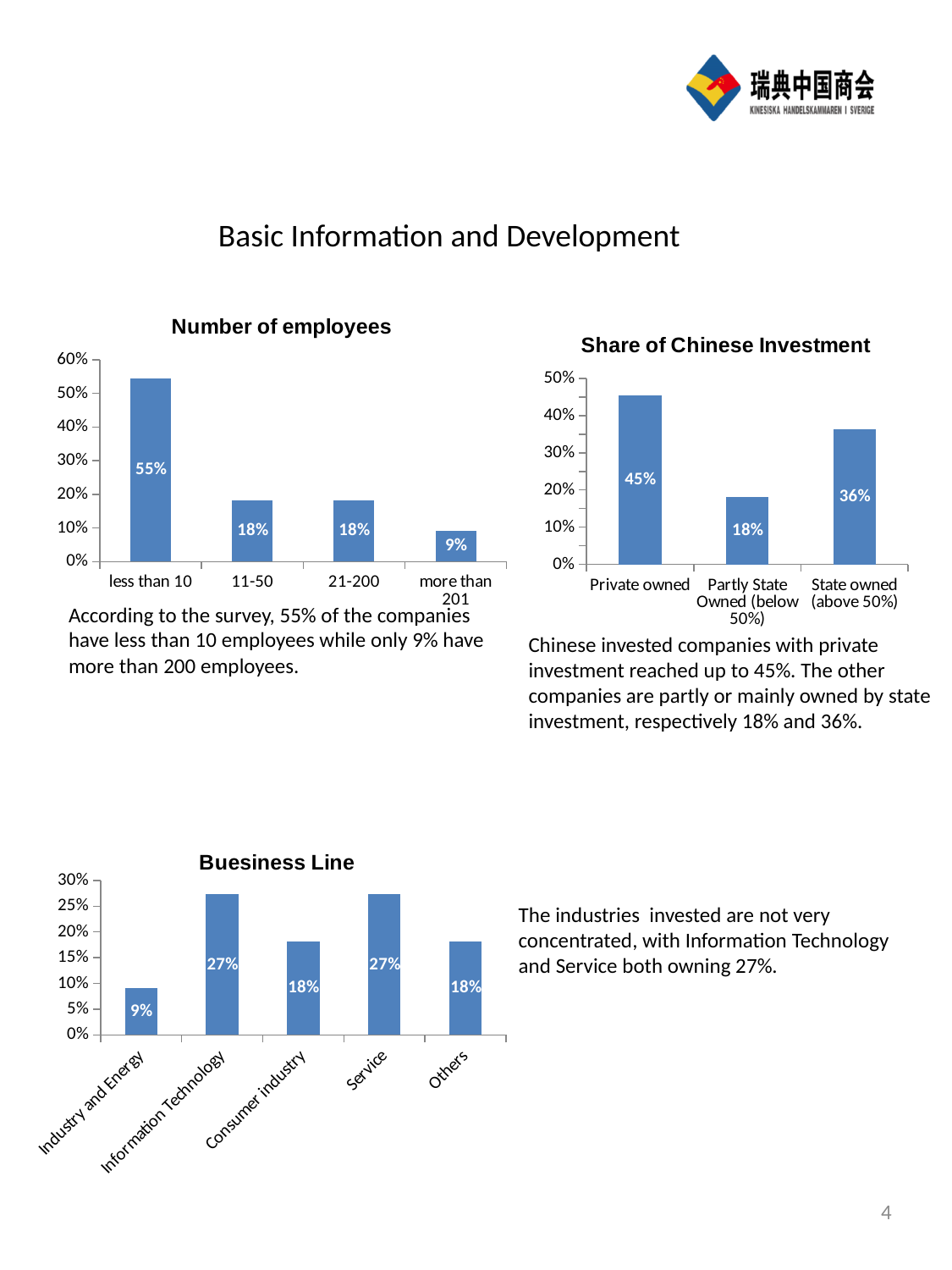
What type of chart is the 'Buesiness Line' chart? Bar chart In the 'Number of employees' chart, what is the difference between 'less than 10' and 'more than 201'? 46% In the 'Share of Chinese Investment' chart, which category has the highest value? Private owned In the 'Share of Chinese Investment' chart, what is the value for 'State owned (above 50%)'? 36% In the 'Number of employees' chart, what is the value for 'less than 10'? 55% In the 'Buesiness Line' chart, which category has the lowest value? Industry and Energy In the 'Share of Chinese Investment' chart, what is the difference between 'Private owned' and 'Partly State Owned (below 50%)'? 27% How many categories are shown in the 'Number of employees' chart? 4 How many categories are shown in the 'Buesiness Line' chart? 5 In the 'Buesiness Line' chart, what is the value for 'Consumer industry'? 18% In the 'Number of employees' chart, which category has the lowest value? more than 201 In the 'Share of Chinese Investment' chart, which is larger: 'Partly State Owned (below 50%)' or 'State owned (above 50%)'? State owned (above 50%)